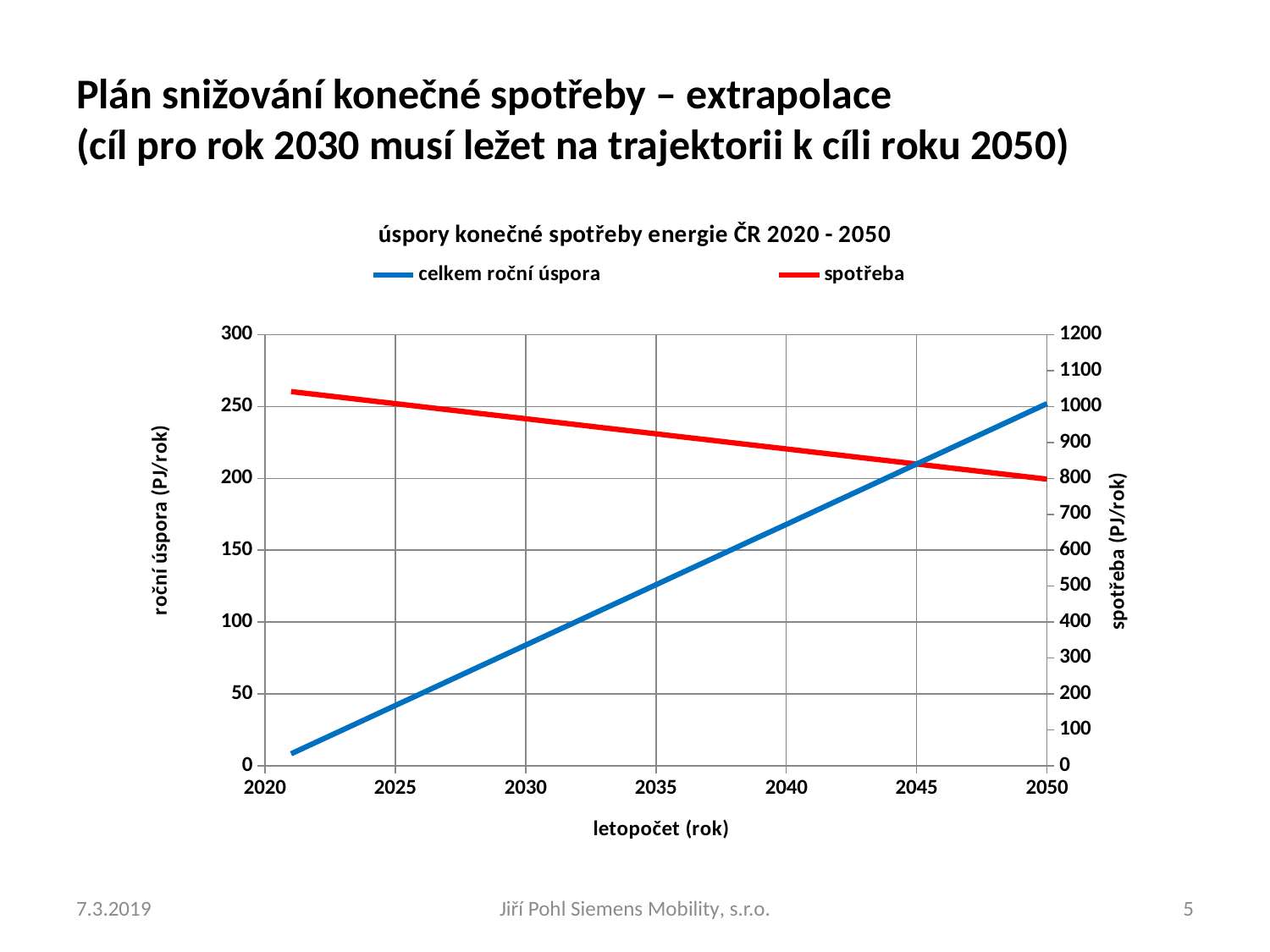
Does the 'spotřeba' series rise or fall from 2020 to 2050? fall Which colour is used for the 'spotřeba' series? red Is the value of 'spotřeba' in 2030 greater or less than 1000? less Is the value of 'celkem roční úspora' in 2030 greater or less than 50? greater Is the value of 'celkem roční úspora' in 2025 greater or less than 100? less Does the 'celkem roční úspora' series rise or fall from 2020 to 2050? rise What is the title of the chart? úspory konečné spotřeby energie ČR 2020 - 2050 What kind of chart is shown on the slide? line chart How many series does the legend list? 2